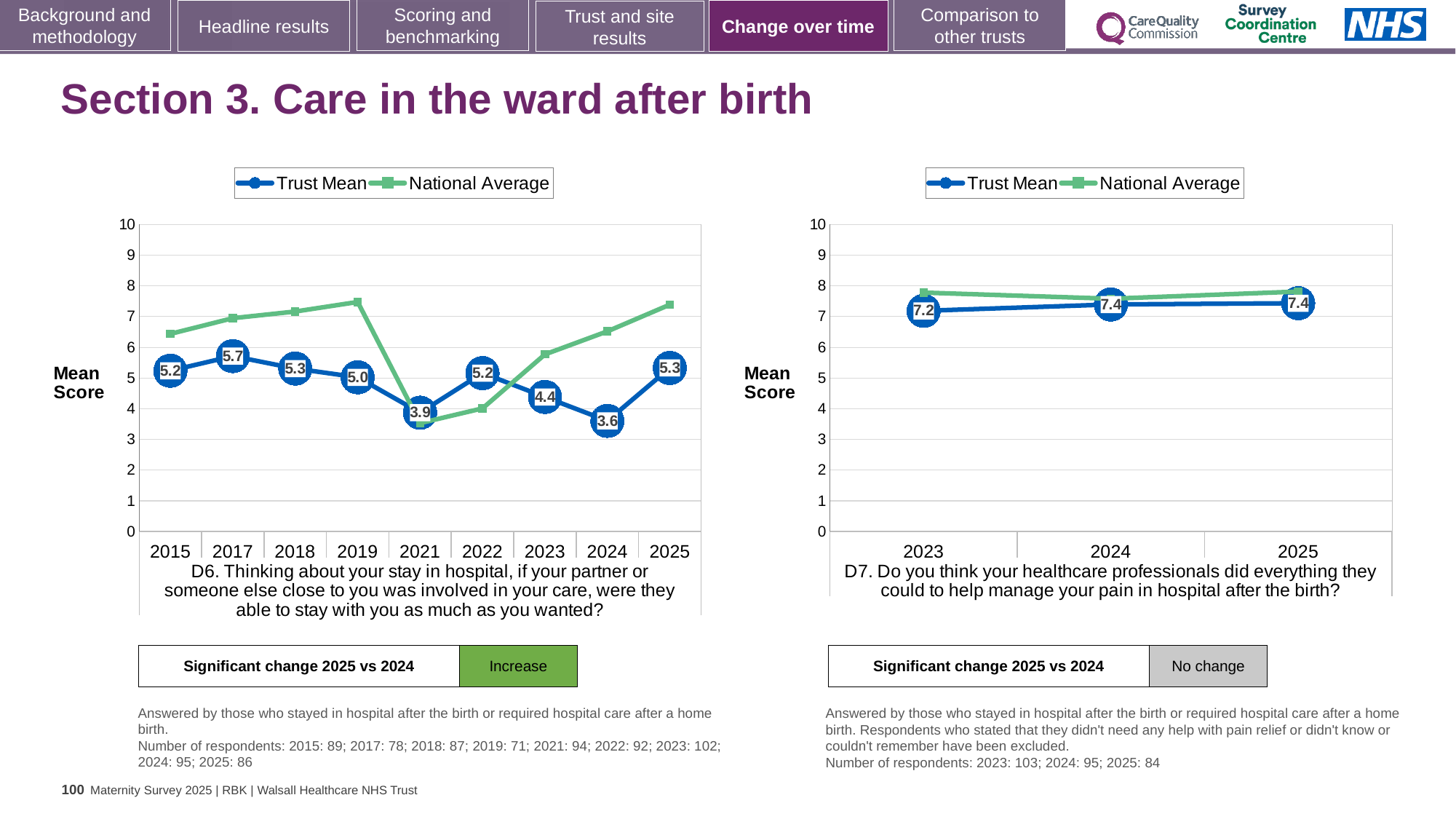
In the D6 chart on the left, which year has the lowest Trust Mean? 2024 In the D6 chart on the left, is the National Average for 2019 greater or less than 7? greater In the D6 chart on the left, which year has the highest Trust Mean? 2017 In the D7 chart on the right, how many series does the legend list? 2 In the D6 chart on the left, what is the Trust Mean for 2025? 5.3 In the D7 chart on the right, what is the difference between the Trust Mean for 2024 and for 2023? 0.2 What kind of chart is the D7 chart on the right? Line chart In the D6 chart on the left, is the Trust Mean for 2017 larger or smaller than the Trust Mean for 2024? Larger In the D6 chart on the left, how many years are shown on the x axis? 9 In the D6 chart on the left, what is the Trust Mean for 2021? 3.9 In the D7 chart on the right, what is the Trust Mean for 2023? 7.2 In the D6 chart on the left, what is the difference between the Trust Mean for 2025 and for 2024? 1.7